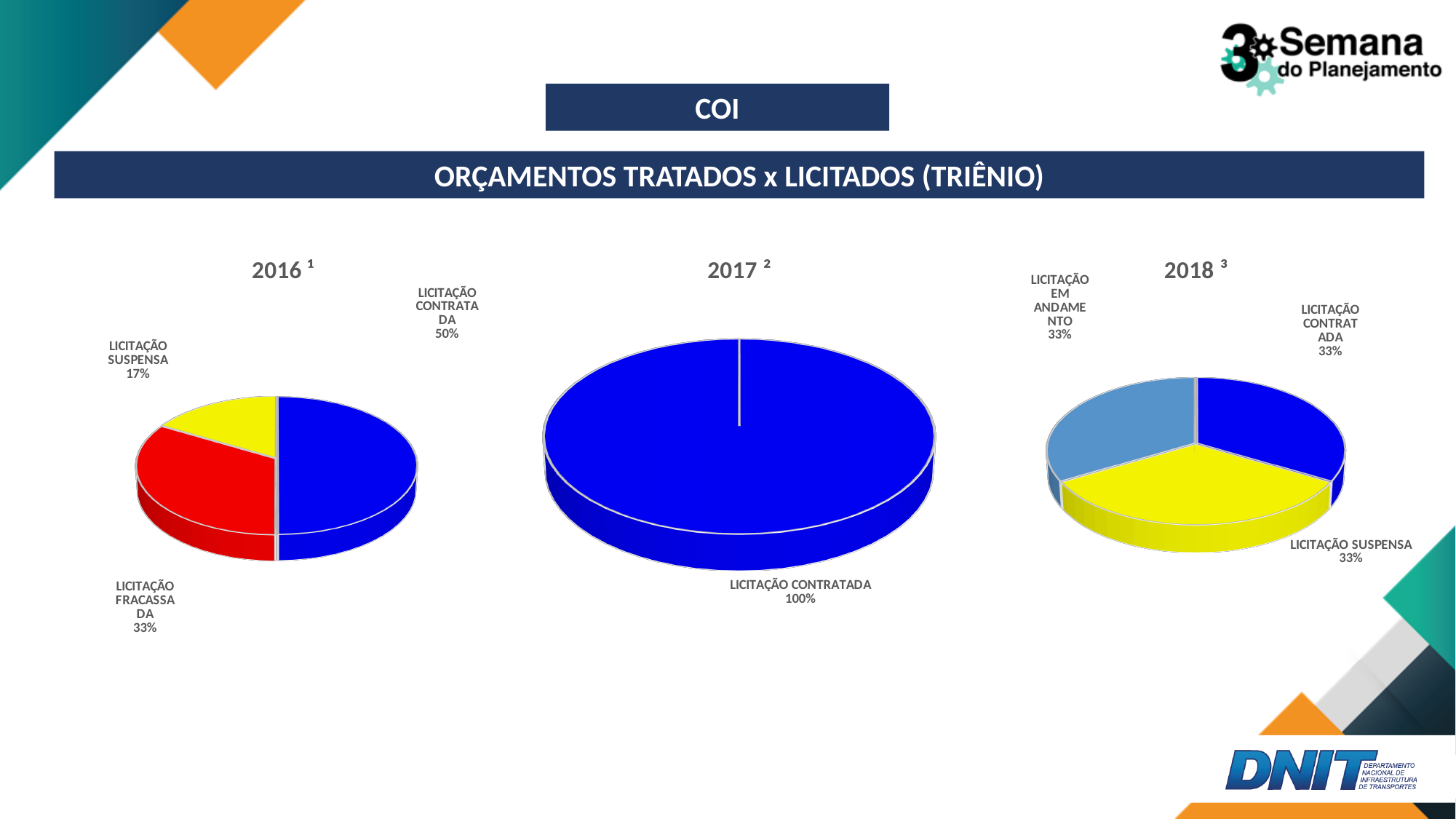
In the 2018 pie chart, what share is LICITAÇÃO EM ANDAMENTO? 33% In the 2016 pie chart, what share is LICITAÇÃO CONTRATADA? 50% In the 2016 pie chart, which category has the largest share? LICITAÇÃO CONTRATADA In the 2016 pie chart, how many slices are there? 3 In the 2017 pie chart, what share is LICITAÇÃO CONTRATADA? 100% In the 2016 pie chart, what is the difference between the LICITAÇÃO CONTRATADA share and the LICITAÇÃO SUSPENSA share? 33% In the 2017 pie chart, how many categories are shown? 1 What kind of chart is used for the 2017 data? Pie chart In the 2016 pie chart, which category has the smallest share? LICITAÇÃO SUSPENSA In the 2018 pie chart, how many slices are there? 3